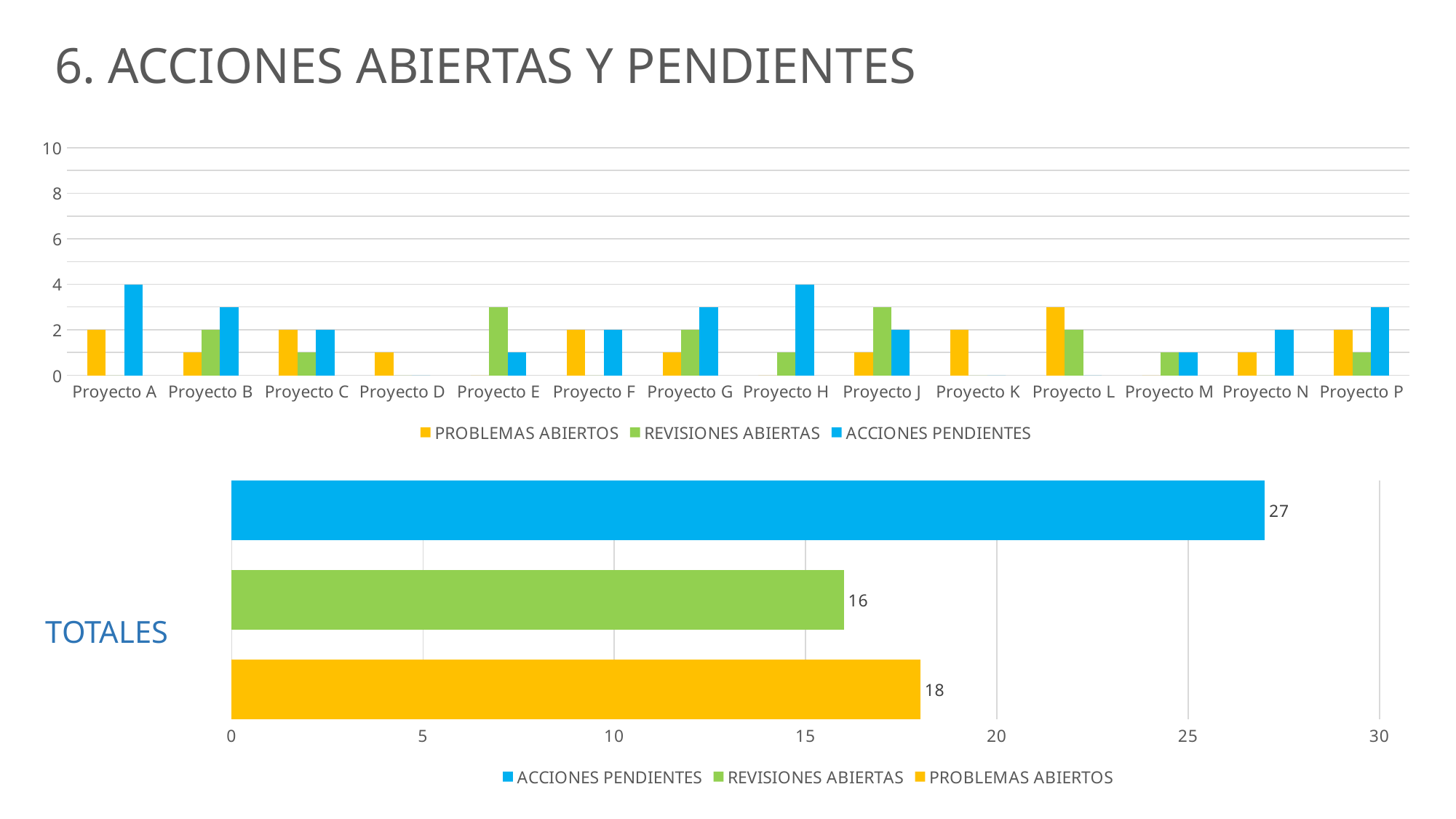
In the top chart, how many series does the legend list? 3 In the bottom chart (TOTALES), which series has the lowest total? REVISIONES ABIERTAS In the bottom chart (TOTALES), what is the value for REVISIONES ABIERTAS? 16 In the bottom chart (TOTALES), which series has the highest total? ACCIONES PENDIENTES In the bottom chart (TOTALES), which is larger: PROBLEMAS ABIERTOS or REVISIONES ABIERTAS? PROBLEMAS ABIERTOS In the bottom chart (TOTALES), what is the value for PROBLEMAS ABIERTOS? 18 In the top chart, is the value of REVISIONES ABIERTAS for Proyecto E greater or less than 2? greater In the top chart, what is the value of ACCIONES PENDIENTES for Proyecto A? 4 In the bottom chart (TOTALES), what is the value for ACCIONES PENDIENTES? 27 In the top chart, how many projects are shown on the x axis? 14 In the bottom chart (TOTALES), what is the difference between ACCIONES PENDIENTES and PROBLEMAS ABIERTOS? 9 What kind of chart is the bottom chart (TOTALES)? Bar chart